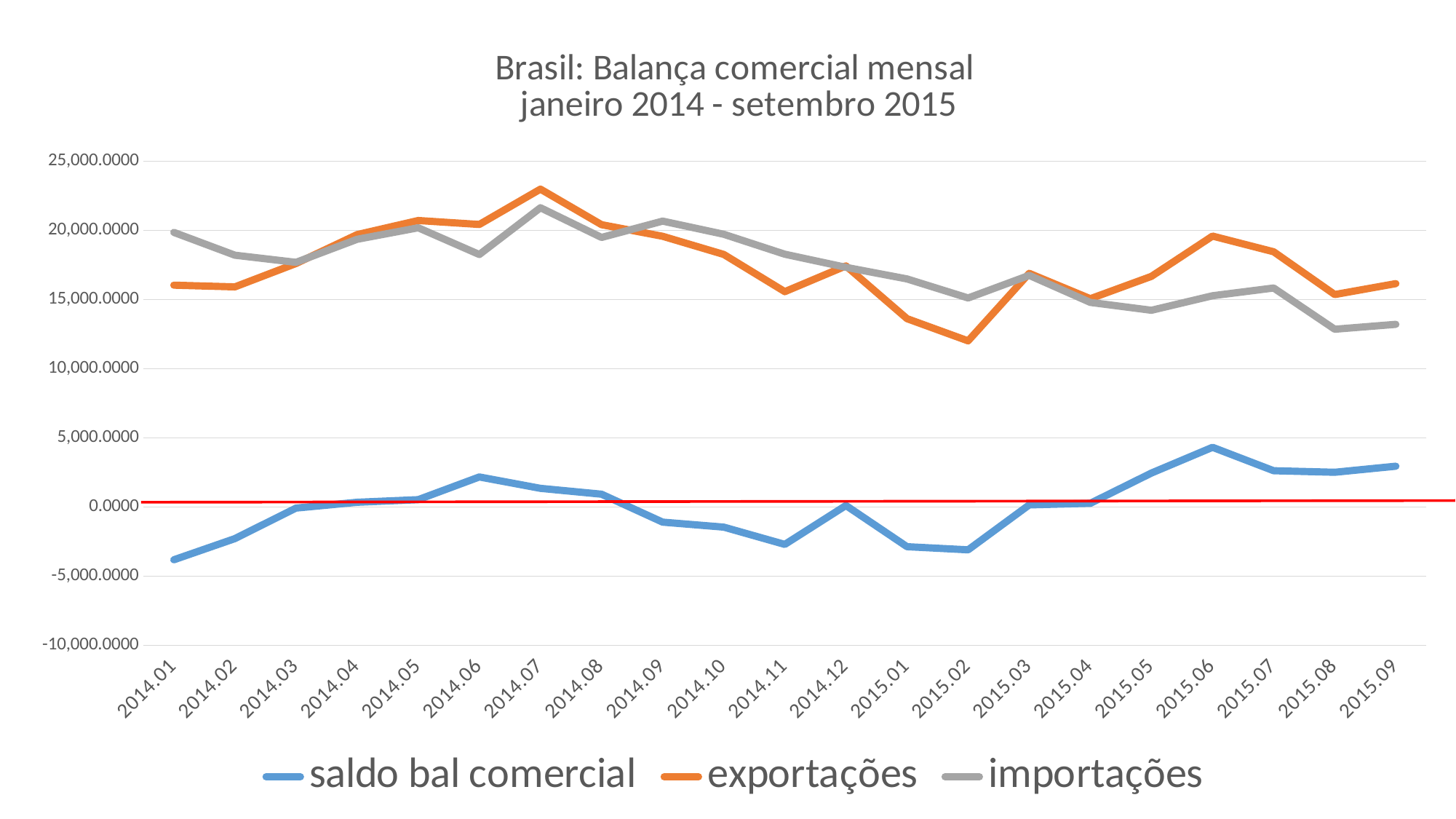
What is the title of the chart? Brasil: Balança comercial mensal janeiro 2014 - setembro 2015 In which month is the saldo bal comercial series at its lowest? 2014.01 Is the value for exportações in 2014.07 greater or less than 20,000.0000? greater In which month does the exportações series reach its highest value? 2014.07 Is the value for importações in 2015.08 greater or less than 15,000.0000? less In which month is the saldo bal comercial series at its highest? 2015.06 How many months are plotted along the x axis? 21 Which is larger in 2015.06, exportações or importações? exportações What kind of chart is shown on the slide? line chart In which month does the exportações series reach its lowest value? 2015.02 Does the importações series generally rise or fall from 2014.09 to 2015.09? fall How many series does the legend list? 3